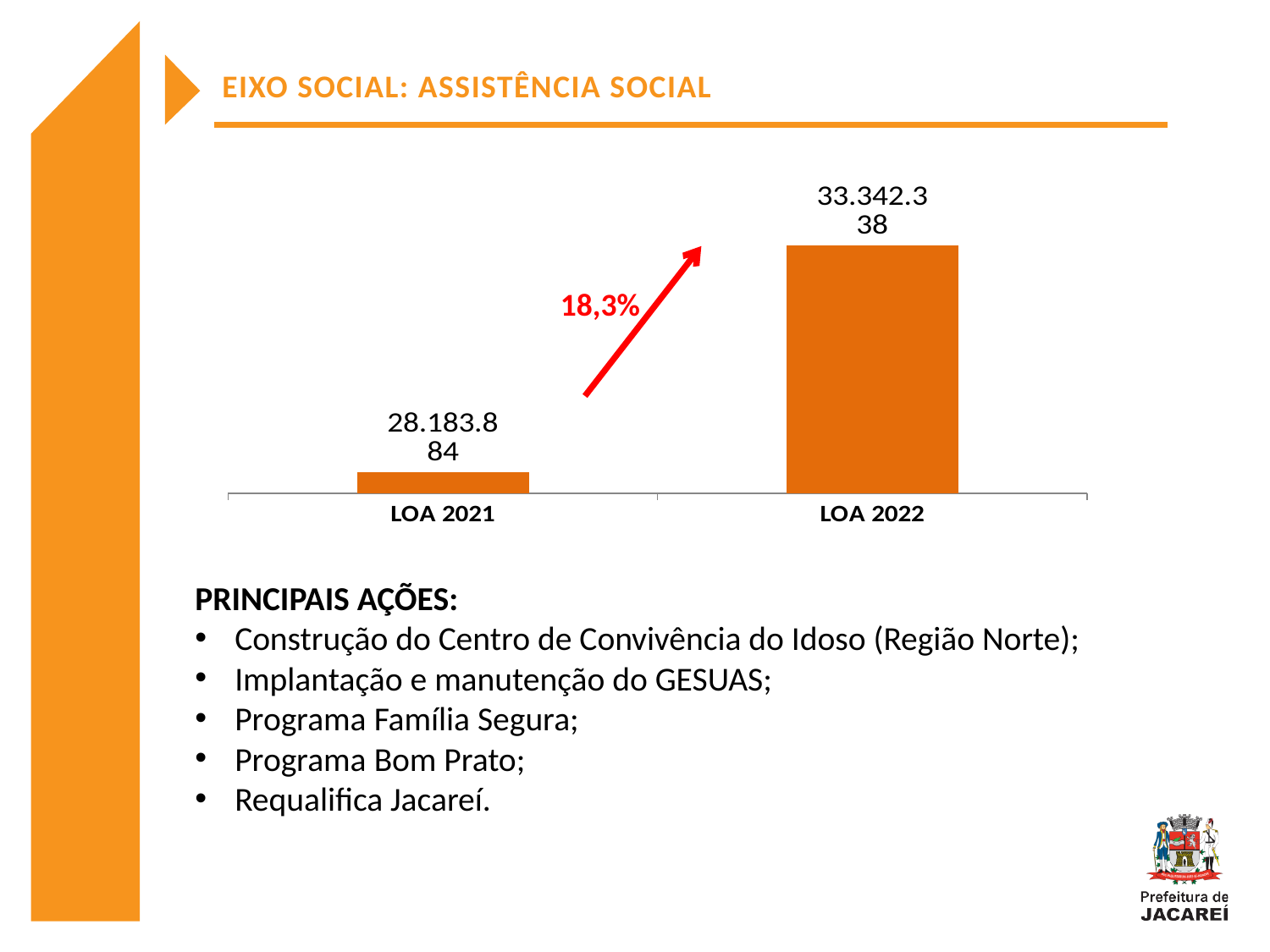
What kind of chart is shown on the slide? Bar chart Which category has the highest value? LOA 2022 What is the difference between the values for LOA 2022 and LOA 2021? 5.158.454 What is the value shown for LOA 2021? 28.183.884 Do the values rise or fall from LOA 2021 to LOA 2022? Rise Which category has the lowest value? LOA 2021 What colour are the bars in the chart? Orange What percentage change is annotated next to the red arrow on the chart? 18,3% What is the value shown for LOA 2022? 33.342.338 How many categories are shown on the x axis? 2 Which is larger, the value for LOA 2021 or LOA 2022? LOA 2022